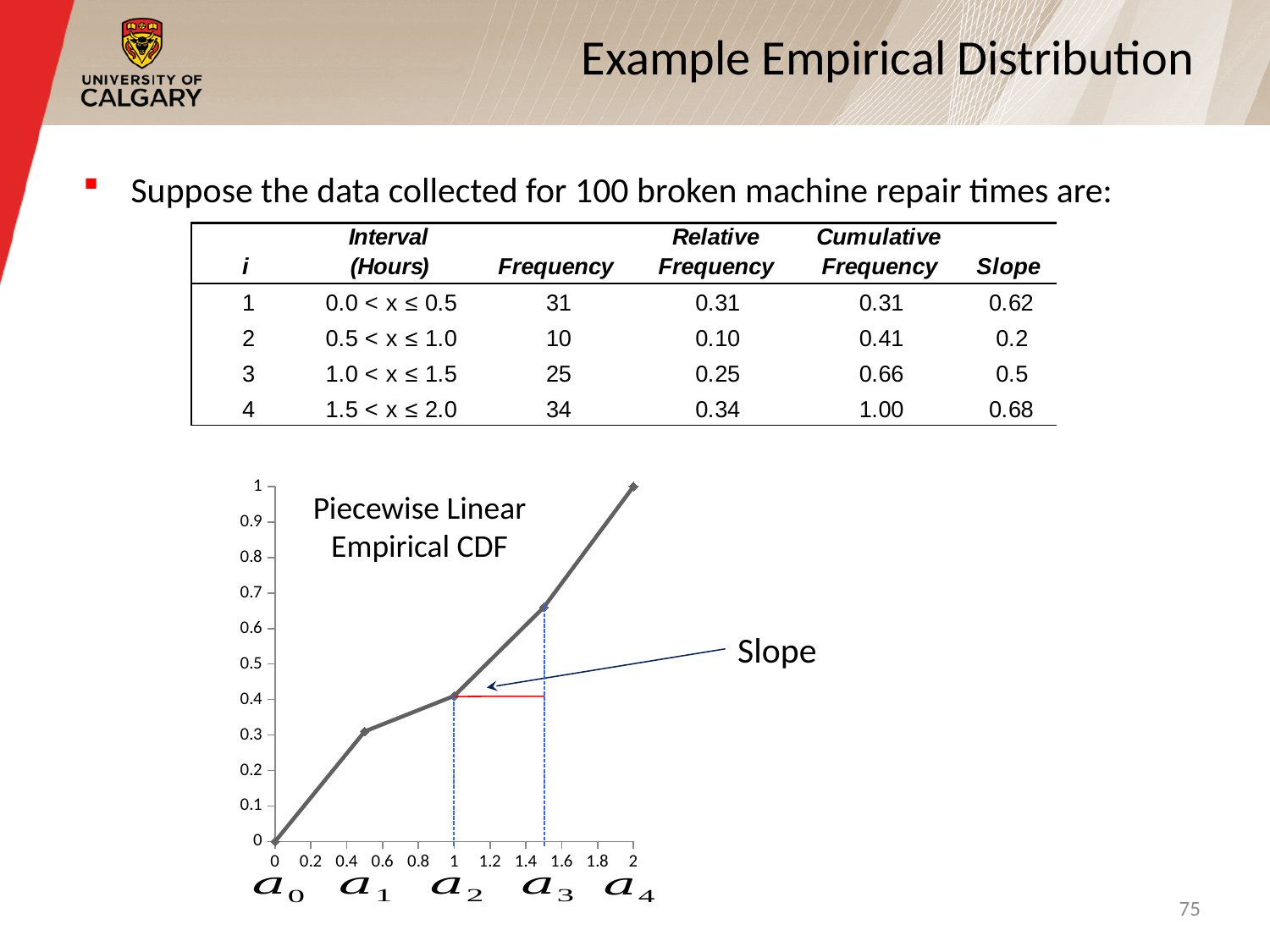
What kind of chart is the Piecewise Linear Empirical CDF chart? line chart Is the value of the Piecewise Linear Empirical CDF at x = 1.5 greater or less than 0.6? greater Is the value of the Piecewise Linear Empirical CDF at x = 1 greater or less than 0.5? less How many data points are plotted on the Piecewise Linear Empirical CDF line? 5 What is the value of the Piecewise Linear Empirical CDF at x = 2? 1 Do the values on the Piecewise Linear Empirical CDF chart rise or fall as x increases from 0 to 2? rise What does the label pointed to by the arrow on the chart say? Slope At which x value does the Piecewise Linear Empirical CDF reach its highest value? 2 On the Piecewise Linear Empirical CDF chart, which is larger: the value at x = 1.5 or the value at x = 0.5? x = 1.5 Is the value of the Piecewise Linear Empirical CDF at x = 0.5 greater or less than 0.4? less What is the title text shown inside the chart? Piecewise Linear Empirical CDF What is the value of the Piecewise Linear Empirical CDF at x = 0? 0